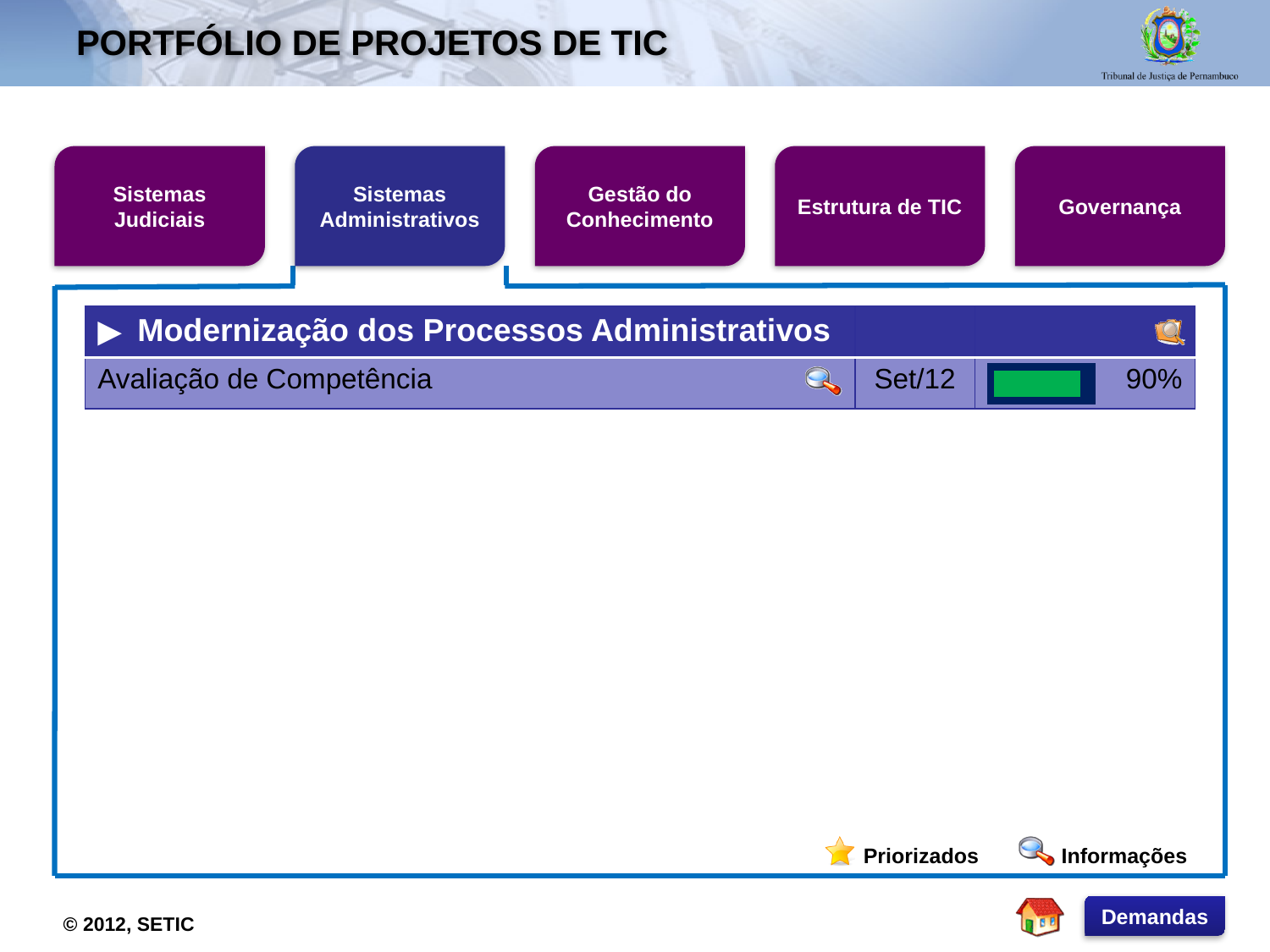
What kind of visual is used to show the progress of "Avaliação de Competência"? a progress bar What completion percentage is shown for the project "Avaliação de Competência"? 90% How many projects are listed under "Modernização dos Processos Administrativos"? 1 What date is shown next to the project "Avaliação de Competência"? Set/12 Is the completion value for "Avaliação de Competência" greater or less than 50%? greater Which tab is selected on the slide? Sistemas Administrativos What colour is the filled portion of the progress bar for "Avaliação de Competência"? green